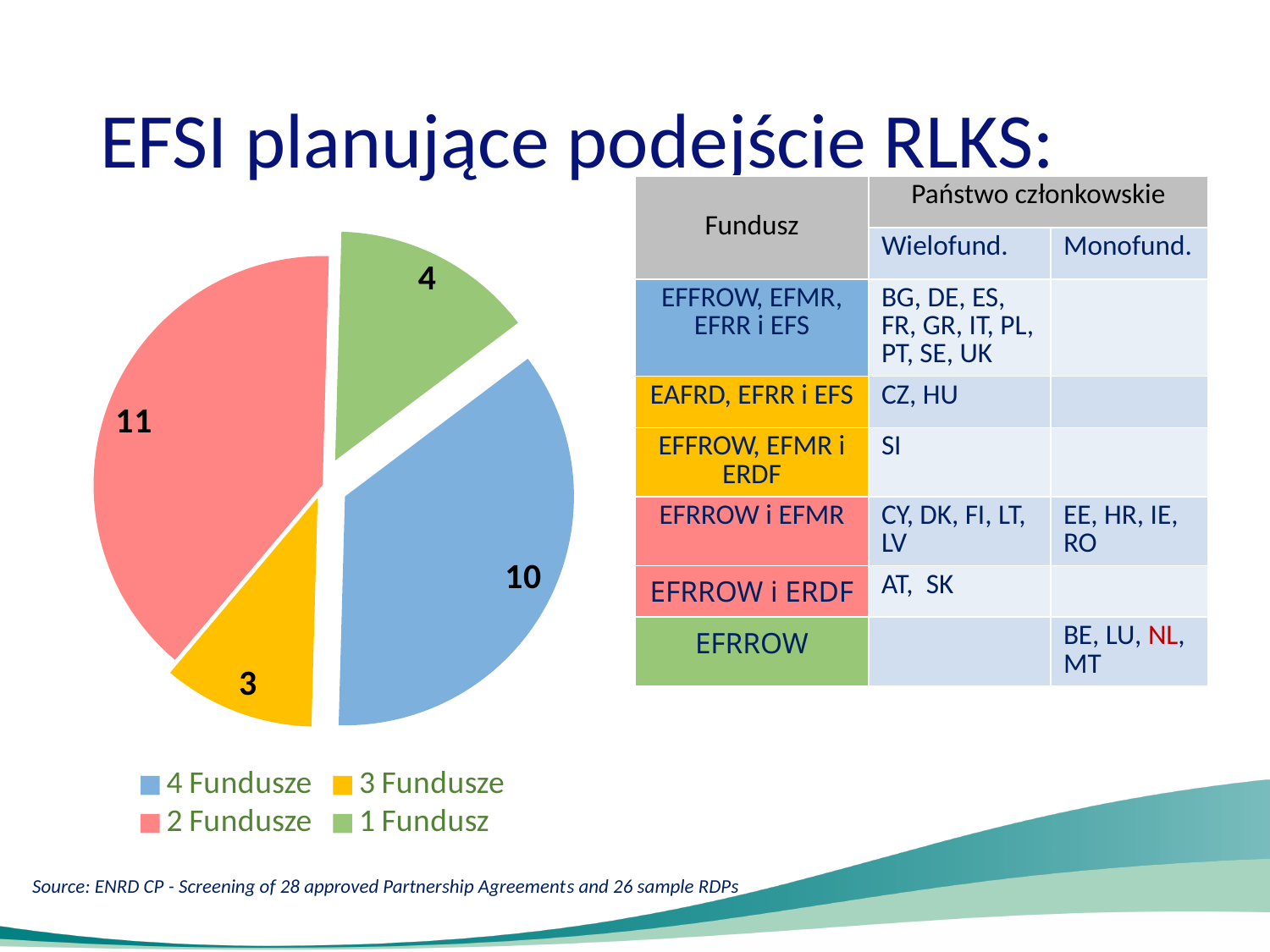
What is the value for the "1 Fundusz" slice? 4 What colour is the "2 Fundusze" slice in the pie chart? red (pink) What is the value for the "2 Fundusze" slice? 11 Which category has the largest slice of the pie? 2 Fundusze What type of chart is shown on the slide? pie chart What is the total of all the slice values in the pie chart? 28 Which category has the smallest slice of the pie? 3 Fundusze How many slices does the pie chart have? 4 Which is larger, the value for "4 Fundusze" or the value for "1 Fundusz"? 4 Fundusze What is the value for the "4 Fundusze" slice? 10 What is the value for the "3 Fundusze" slice? 3 What is the difference between the values for "2 Fundusze" and "3 Fundusze"? 8